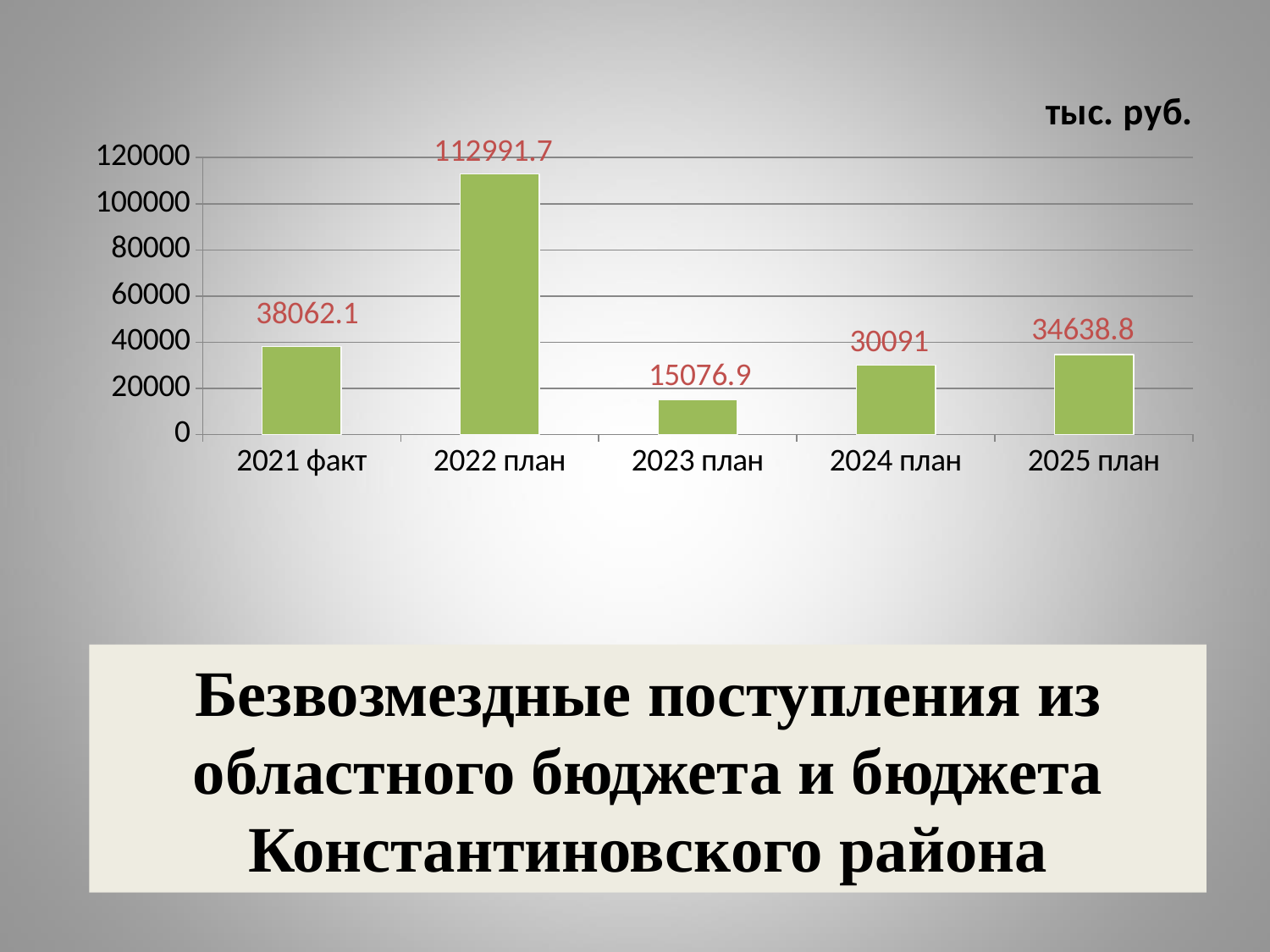
Is the value for 2023 план greater or less than 20000? less How many categories are shown on the x axis? 5 What is the difference between the values for 2025 план and 2024 план? 4547.8 What is the value for 2021 факт? 38062.1 What is the difference between the values for 2022 план and 2021 факт? 74929.6 Which category has the lowest value? 2023 план What is the value for 2024 план? 30091 What is the value for 2022 план? 112991.7 What unit of measurement is indicated above the chart? тыс. руб. Which category has the highest value? 2022 план What kind of chart is shown on the slide? bar chart Which is larger, the value for 2021 факт or the value for 2025 план? 2021 факт